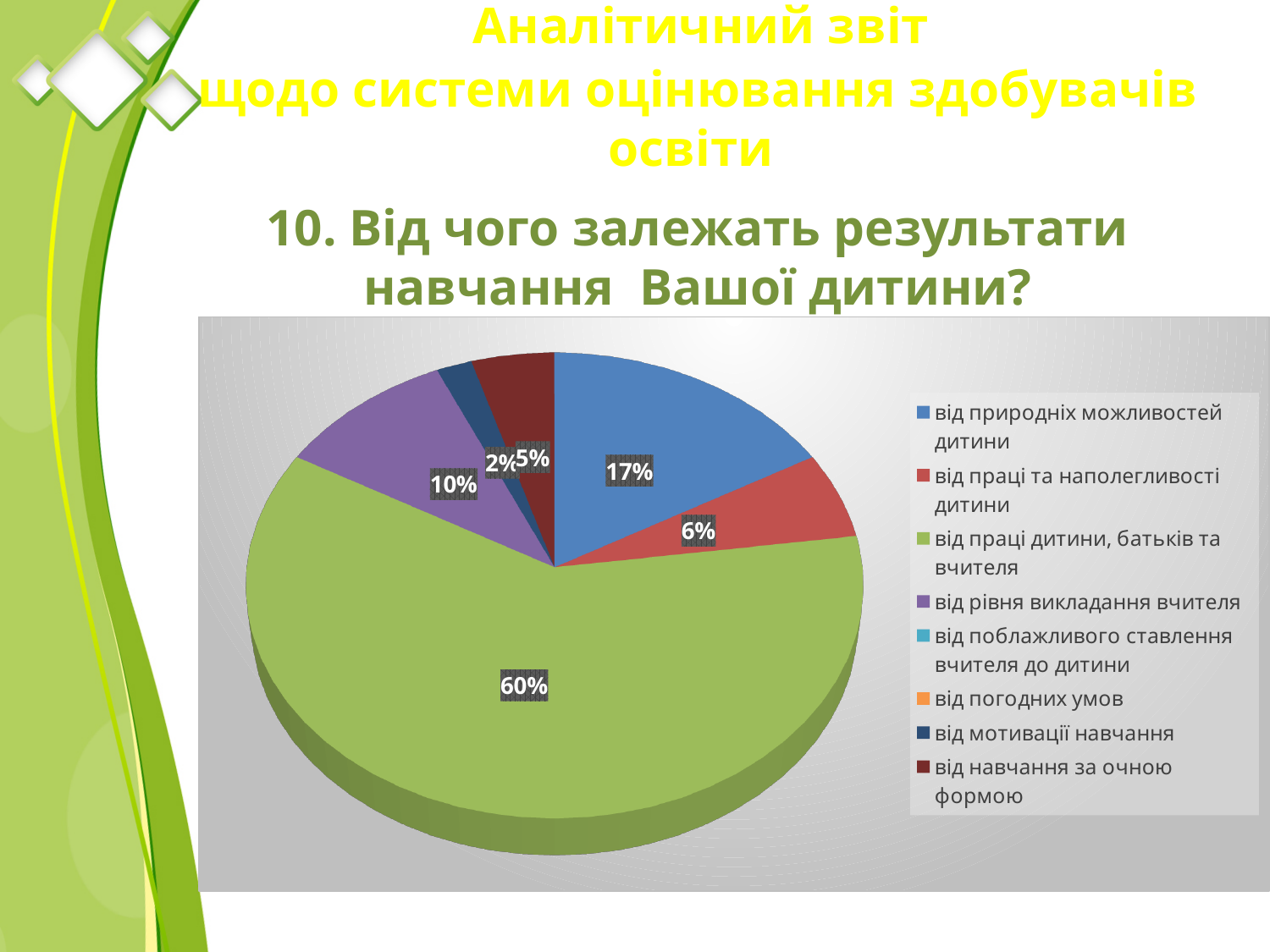
What question number and text is given as the chart's heading? 10. Від чого залежать результати навчання Вашої дитини? Which category has the largest slice of the pie? від праці дитини, батьків та вчителя What share of the pie is labelled for "від рівня викладання вчителя"? 10% Which slice is larger: "від рівня викладання вчителя" or "від праці та наполегливості дитини"? від рівня викладання вчителя What is the difference in percentage points between the slice for "від праці дитини, батьків та вчителя" and the slice for "від природніх можливостей дитини"? 43 What share of the pie is labelled for "від природніх можливостей дитини"? 17% What share of the pie is labelled for "від мотивації навчання"? 2% What share of the pie is labelled for "від праці дитини, батьків та вчителя"? 60% How many entries does the legend list? 8 What share of the pie is labelled for "від праці та наполегливості дитини"? 6% What kind of chart is shown on the slide? pie chart What share of the pie is labelled for "від навчання за очною формою"? 5%